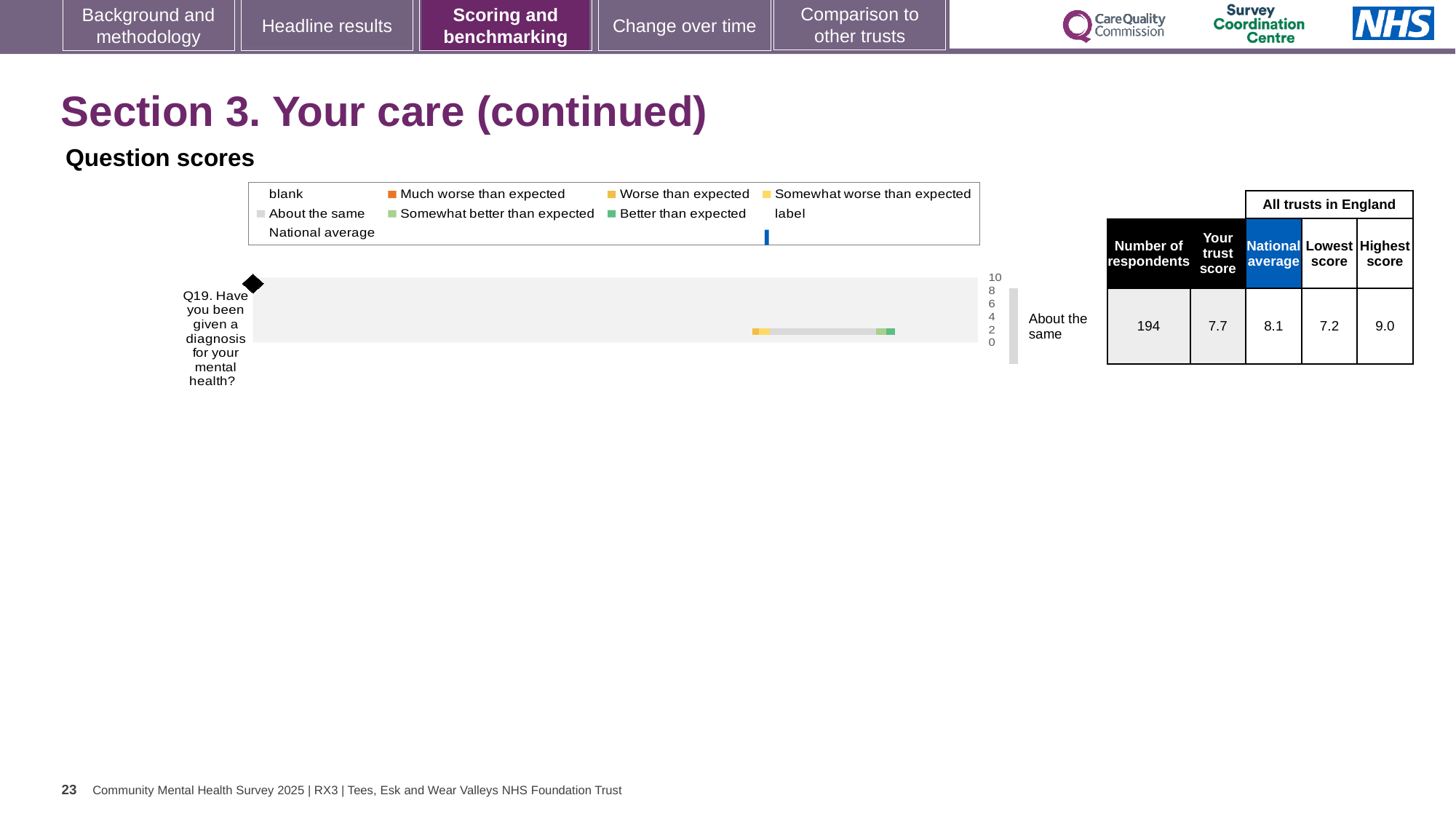
What is the highest score among all trusts in England for Q19? 9.0 What is the trust score for Q19? 7.7 What is the number of respondents for Q19? 194 What kind of chart is shown under 'Question scores'? bar chart What is the lowest score among all trusts in England for Q19? 7.2 Which question is plotted in the Question scores chart? Q19. Have you been given a diagnosis for your mental health? By how much does the national average exceed the trust score for Q19? 0.4 What is the national average for Q19? 8.1 What benchmark category is shown next to the Q19 bar? About the same How many questions are plotted in the Question scores chart? 1 For Q19, which is larger: the trust score or the national average? National average What is the difference between the highest score and the lowest score for Q19? 1.8